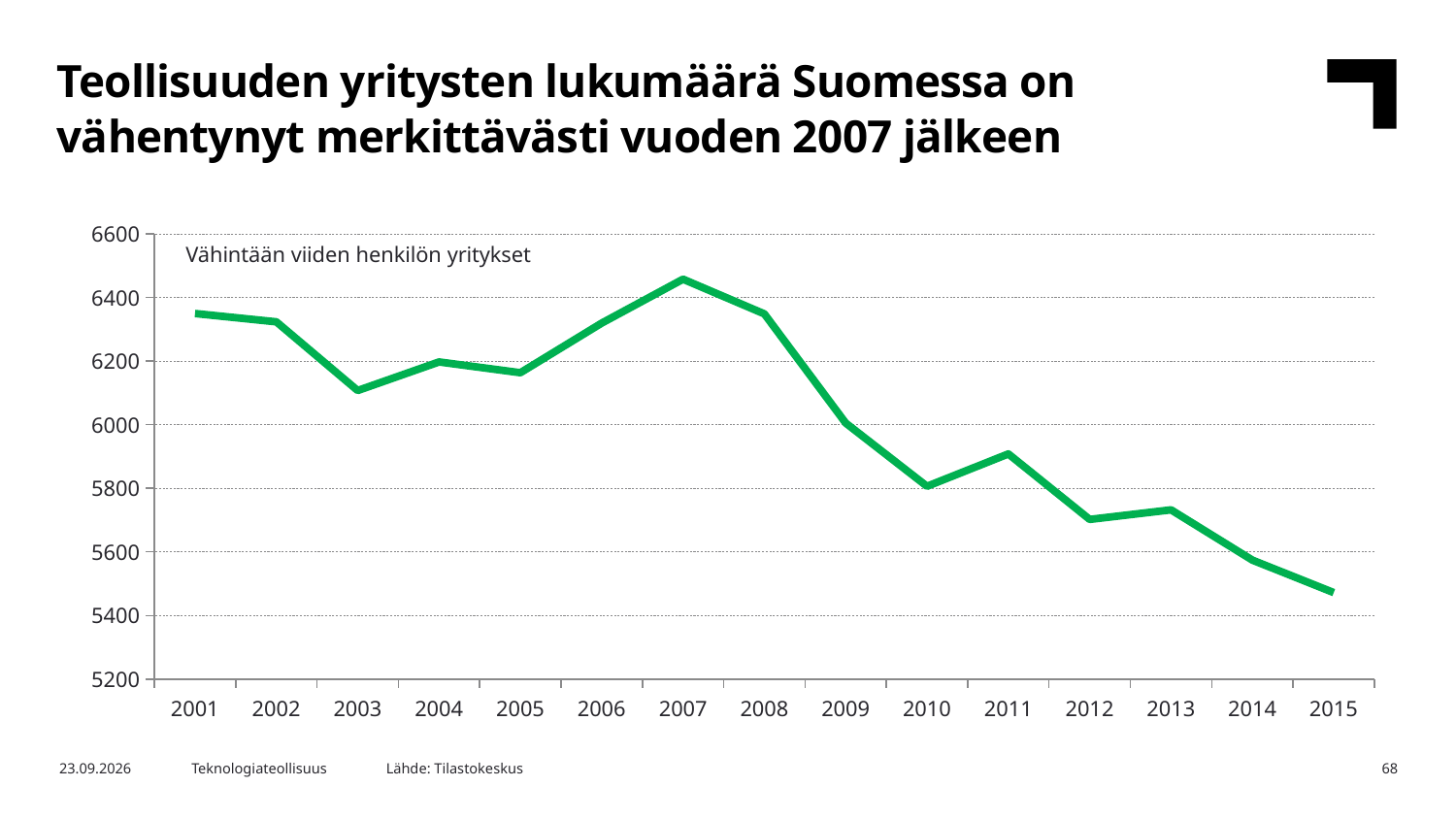
Does the number of companies rise or fall from 2007 to 2015? fall In which year is the number of companies lowest? 2015 Is the value for 2012 greater or less than 5800? less What text label is shown inside the plot area describing the companies included? Vähintään viiden henkilön yritykset How many years are plotted on the x axis? 15 Is the value for 2011 greater or less than 5800? greater Is the value for 2015 greater or less than 5600? less Which year has the larger value, 2003 or 2011? 2003 What kind of chart is shown on the slide? line chart In which year is the number of companies highest? 2007